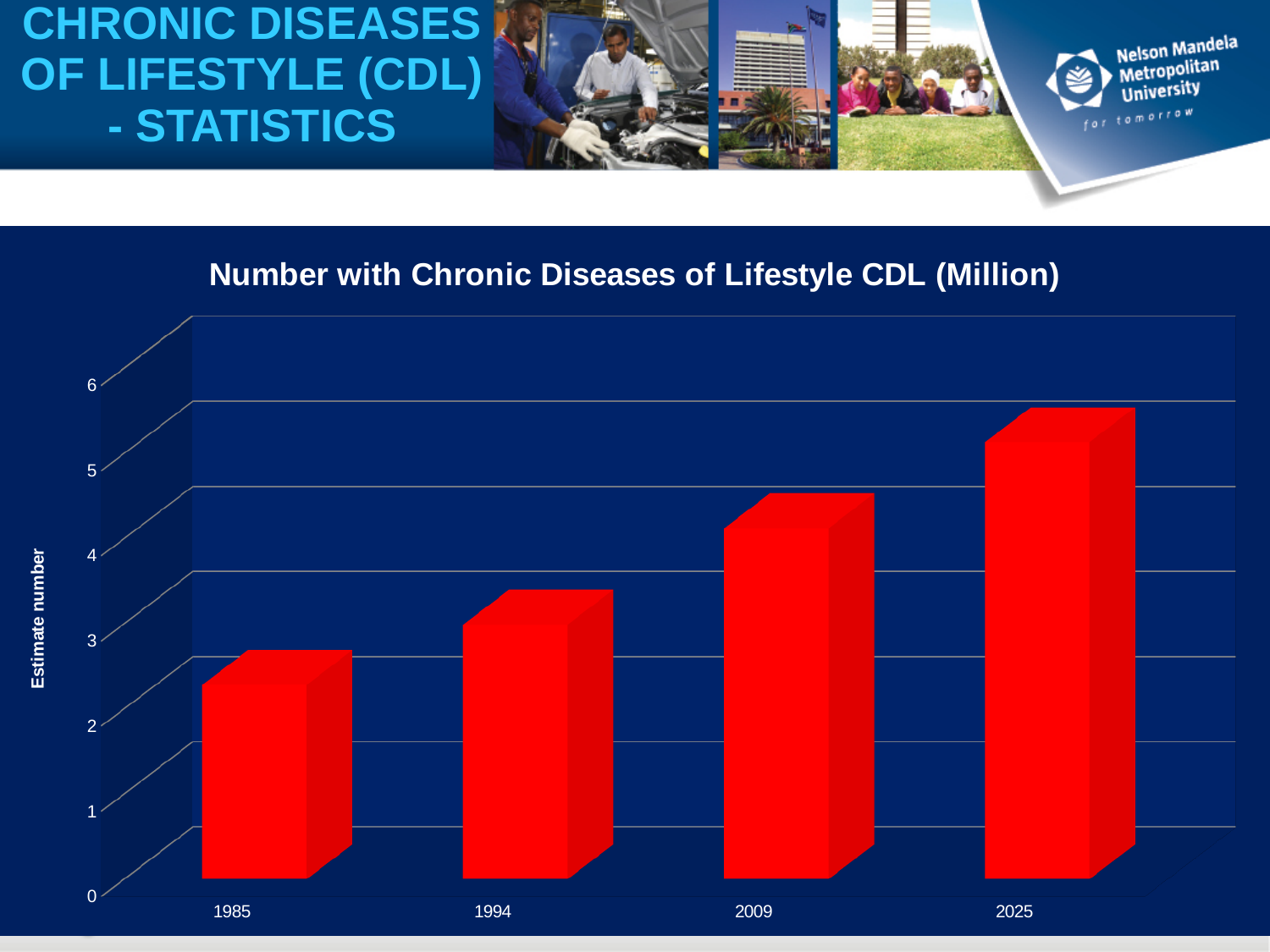
What is the title of the chart? Number with Chronic Diseases of Lifestyle CDL (Million) Is the value for 1985 greater or less than 2? greater How many years are shown on the x axis of the chart? 4 Which is larger, the value for 2009 or the value for 1994? 2009 What kind of chart is shown on the slide? bar chart Which year has the highest estimated number with CDL? 2025 Do the values rise or fall from 1985 to 2025? rise Is the value for 2025 greater or less than 4? greater Is the value for 1994 greater or less than 4? less Which year has the lowest estimated number with CDL? 1985